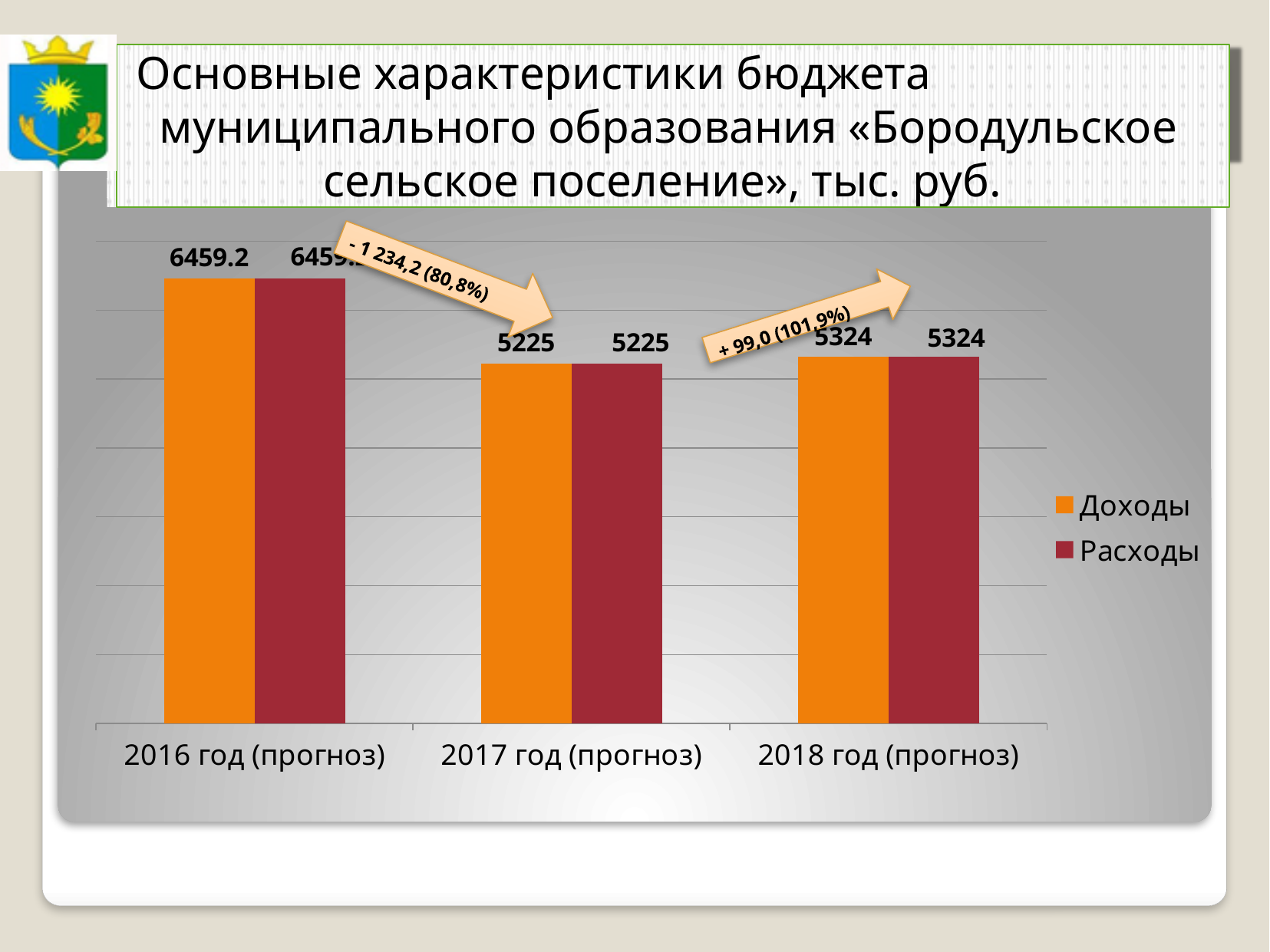
What is the value of Доходы for 2018 год (прогноз)? 5324 Which year has the lowest value of Расходы? 2017 год (прогноз) What is the difference between Доходы in 2018 год (прогноз) and Доходы in 2017 год (прогноз)? 99 What kind of chart is shown on the slide? bar chart What is the value of Доходы for 2016 год (прогноз)? 6459.2 Which colour represents the Расходы series in the legend? dark red How many series does the legend list? 2 Which is larger: Доходы in 2017 год (прогноз) or Доходы in 2018 год (прогноз)? 2018 год (прогноз) How many year categories are shown on the x axis? 3 Which year has the highest value of Доходы? 2016 год (прогноз) What is the value of Расходы for 2018 год (прогноз)? 5324 What is the value of Расходы for 2017 год (прогноз)? 5225